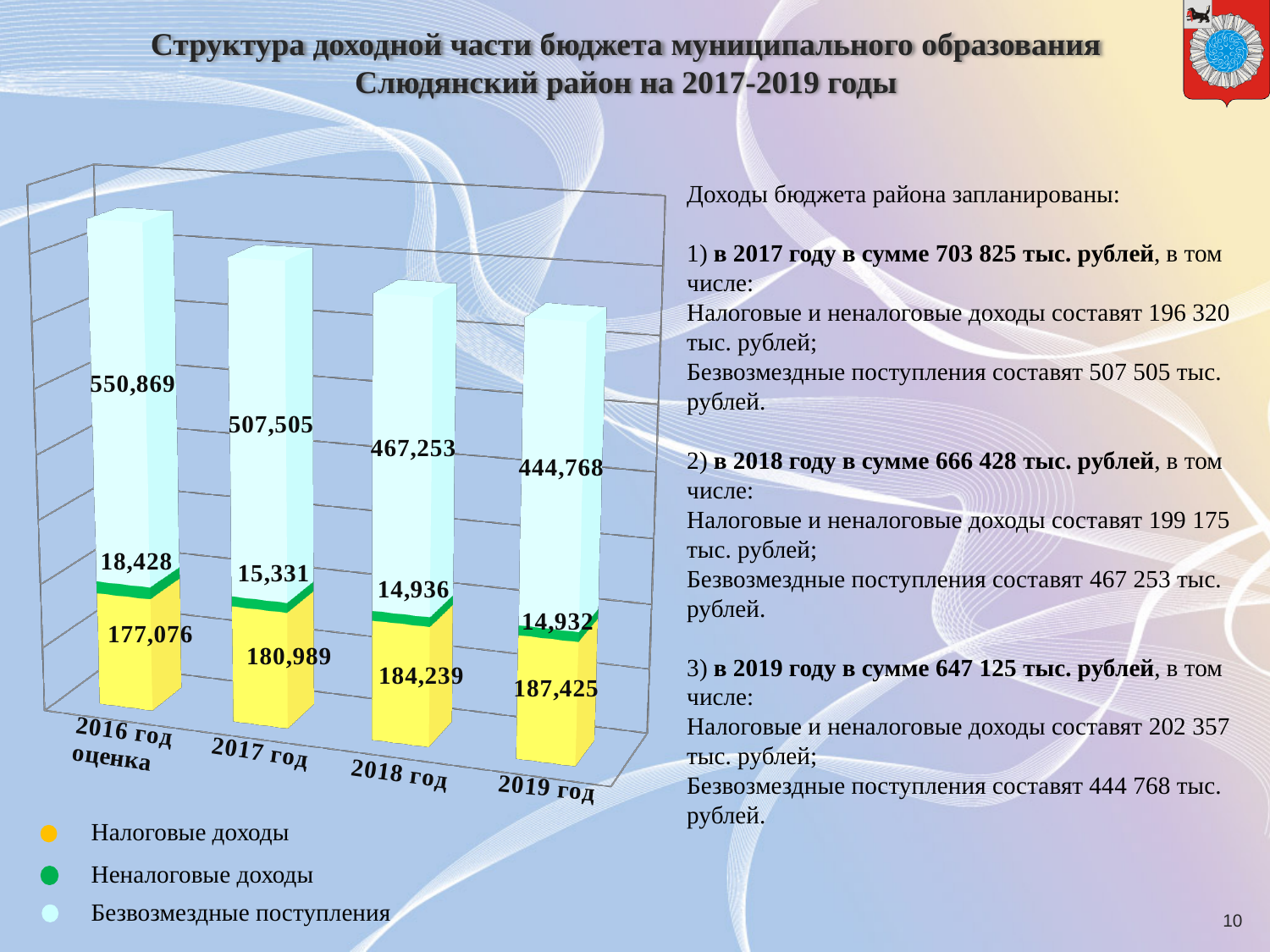
How many series does the chart legend list? 3 What type of chart is shown on the slide? Stacked bar chart Which is larger: Налоговые доходы in 2018 год or in 2017 год? 2018 год How many year categories are shown on the x axis of the chart? 4 What is the value of Безвозмездные поступления for 2016 год оценка? 550,869 What is the value of Неналоговые доходы for 2017 год? 15,331 What is the total of the stacked bar for 2019 год? 647,125 What is the value of Налоговые доходы for 2019 год? 187,425 Which year has the lowest value of Налоговые доходы? 2016 год оценка What is the difference between Безвозмездные поступления in 2017 год and 2018 год? 40,252 Do the values of Безвозмездные поступления rise or fall from 2016 год оценка to 2019 год? Fall Which year has the highest value of Безвозмездные поступления? 2016 год оценка